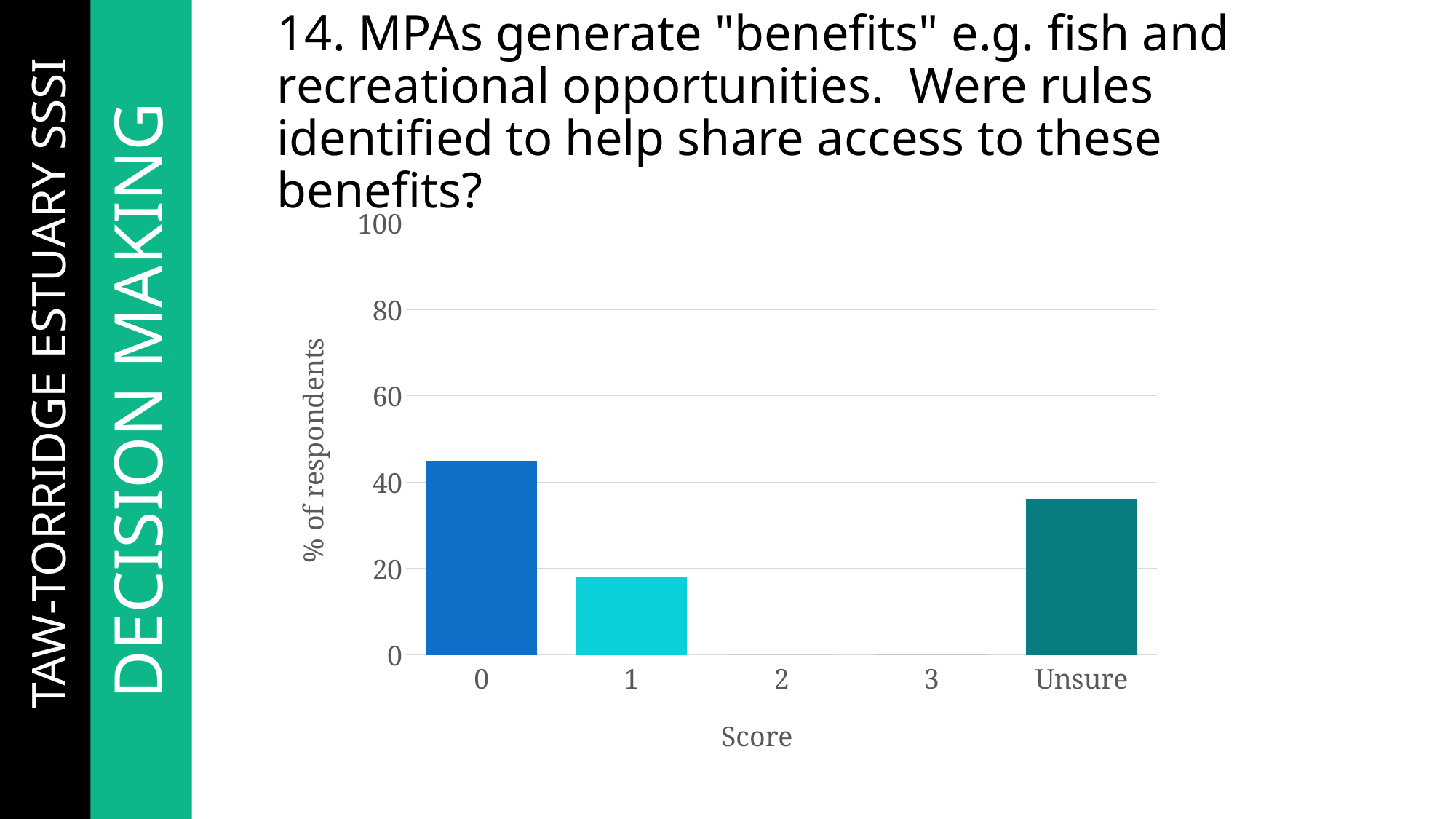
Which score category has the highest percentage of respondents? 0 What is the value for score 2? 0 Which is larger, the value for score 1 or the value for Unsure? Unsure Is the value for score 0 greater or less than 40? greater What is the label of the x axis? Score What is the label of the y axis? % of respondents Is the value for score 1 greater or less than 20? less What kind of chart is shown on the slide? bar chart Is the value for Unsure greater or less than 20? greater How many categories are shown on the x axis of the chart? 5 Which is larger, the value for score 0 or the value for Unsure? score 0